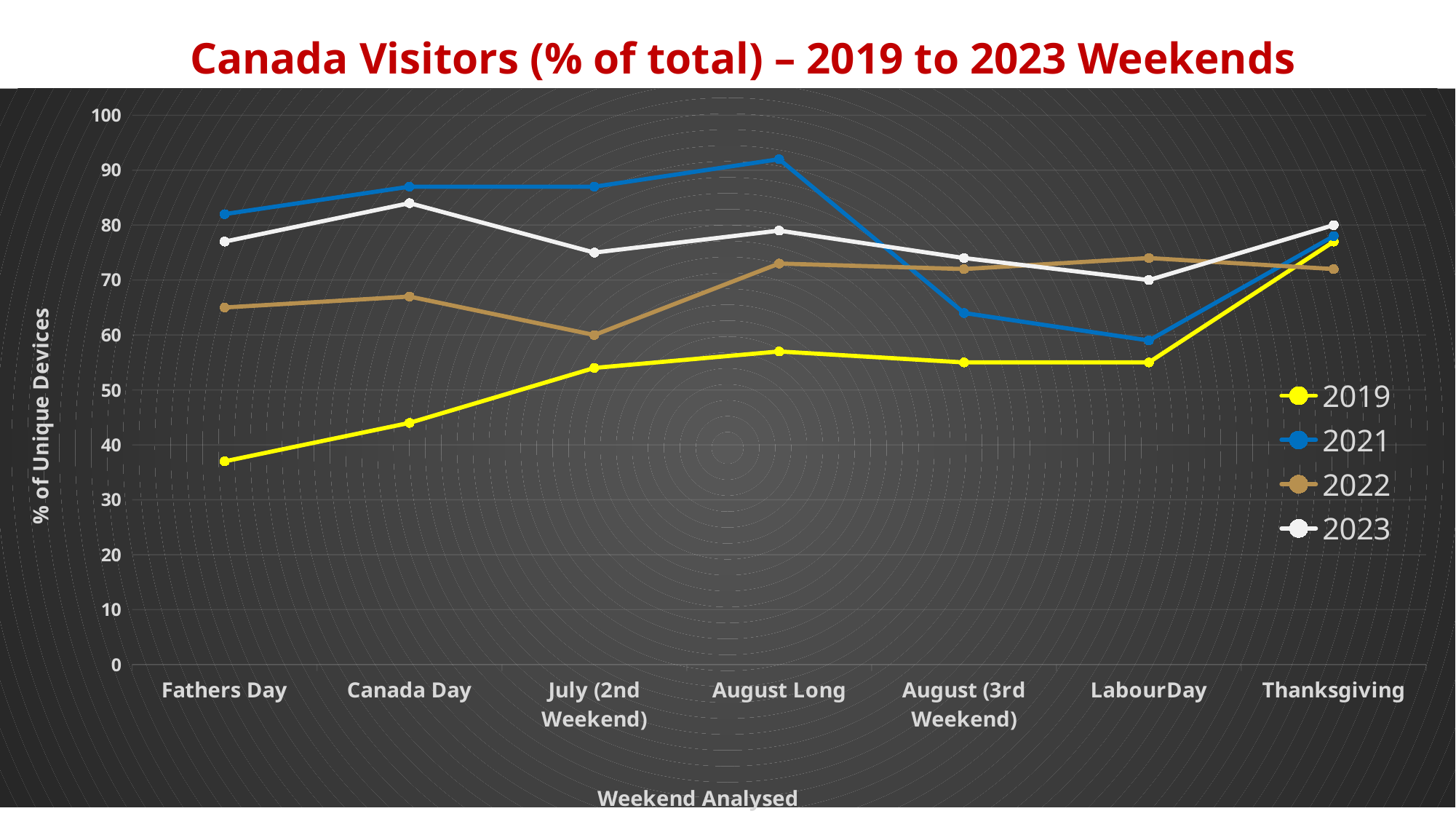
Is the 2019 value for Fathers Day greater or less than 40? less For the 2021 series, which weekend has the highest value? August Long For the 2019 series, which weekend has the highest value? Thanksgiving Is the 2021 value for August Long greater or less than 90? greater How many weekends are plotted along the x axis? 7 What is the label of the y axis? % of Unique Devices For the 2021 series, which weekend has the lowest value? LabourDay Is the 2023 value for Canada Day greater or less than 80? greater What kind of chart is shown on the slide? Line chart How many series does the legend list? 4 On Fathers Day, which series has the larger value, 2021 or 2023? 2021 For the 2019 series, which weekend has the lowest value? Fathers Day